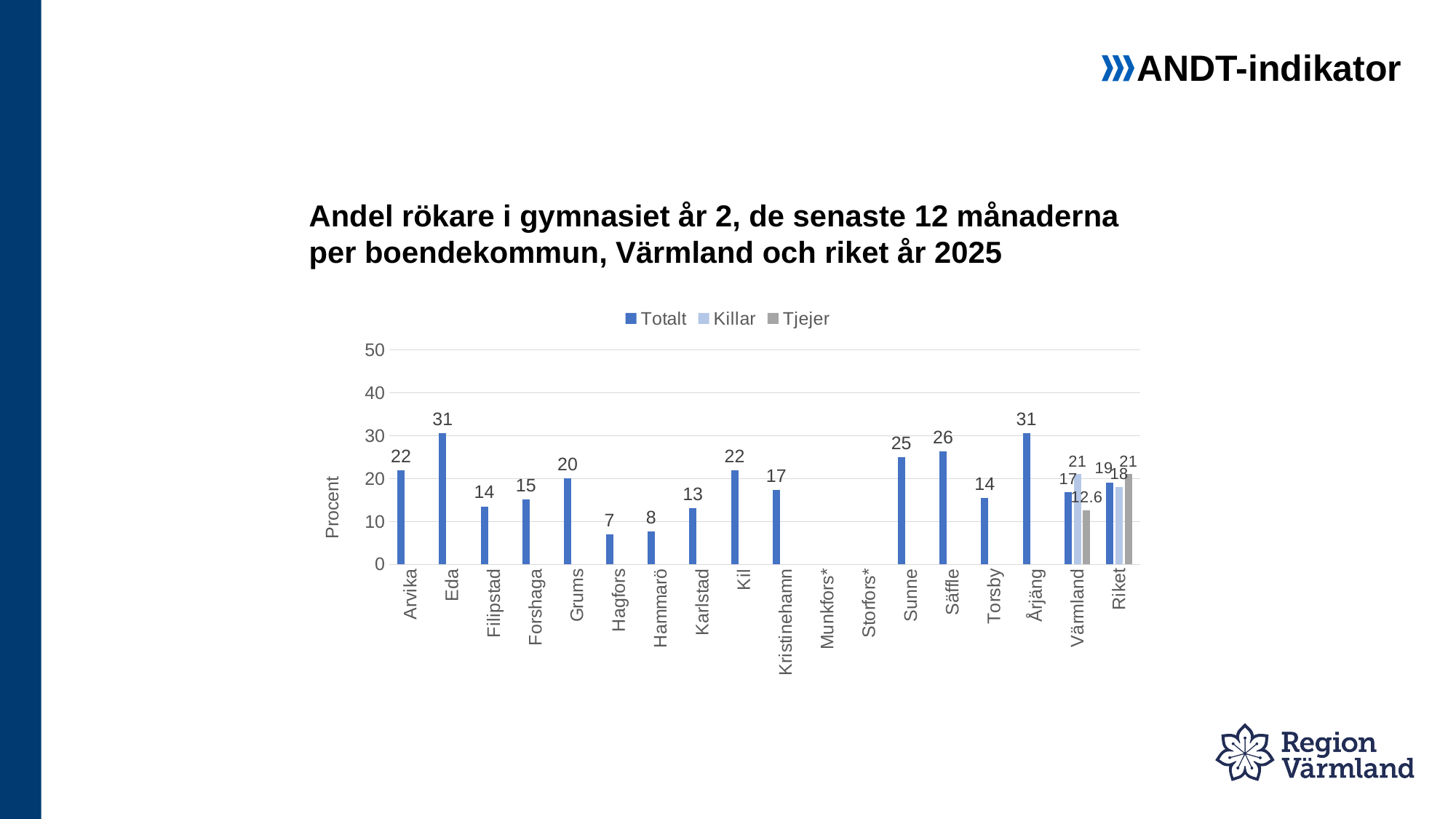
How many categories are shown on the x axis? 18 What is the difference between the Totalt values for Säffle and Sunne? 1 What is the label on the y axis? Procent Is the Totalt value for Kristinehamn greater or less than 20? less Which municipality has the lowest Totalt value? Hagfors What is the Totalt value for Hagfors? 7 What is the Totalt value for Eda? 31 What kind of chart is shown on the slide? bar chart Which has a higher Totalt value, Grums or Forshaga? Grums What is the Tjejer value for Värmland? 12.6 How many series does the legend list? 3 What is the Killar value for Riket? 18